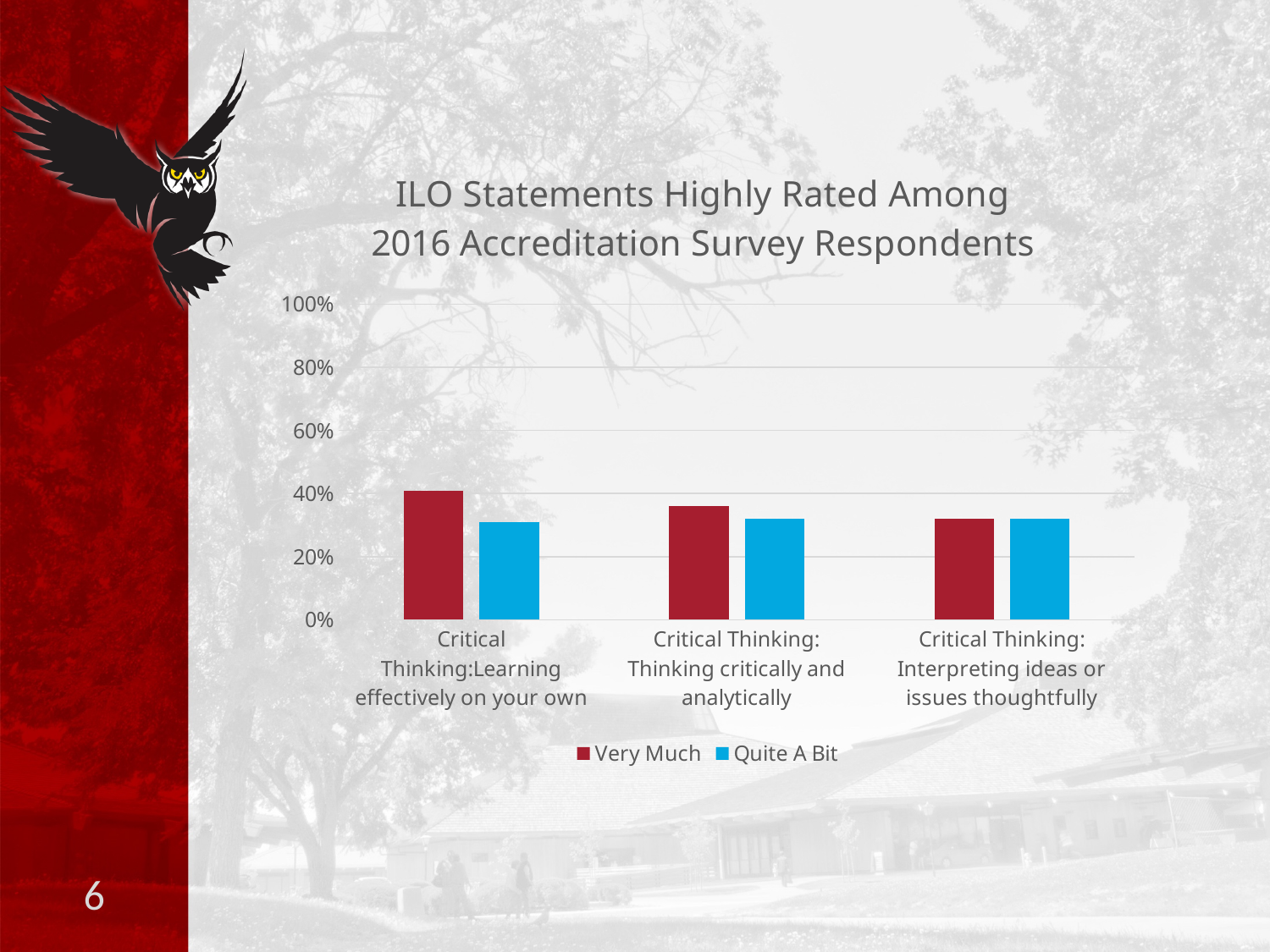
For 'Critical Thinking:Learning effectively on your own', which is larger: 'Very Much' or 'Quite A Bit'? Very Much What is the title of the chart? ILO Statements Highly Rated Among 2016 Accreditation Survey Respondents How many categories are shown on the x axis? 3 For 'Critical Thinking: Thinking critically and analytically', which is larger: 'Very Much' or 'Quite A Bit'? Very Much Which series is shown in blue? Quite A Bit Do the 'Very Much' values rise or fall from left to right across the categories? fall Which category has the lowest 'Very Much' value? Critical Thinking: Interpreting ideas or issues thoughtfully Is the 'Quite A Bit' value for 'Critical Thinking:Learning effectively on your own' greater or less than 40%? less Is the 'Very Much' value for 'Critical Thinking: Thinking critically and analytically' greater or less than 20%? greater How many series does the legend list? 2 What kind of chart is shown on the slide? bar chart Which category has the highest 'Very Much' value? Critical Thinking:Learning effectively on your own